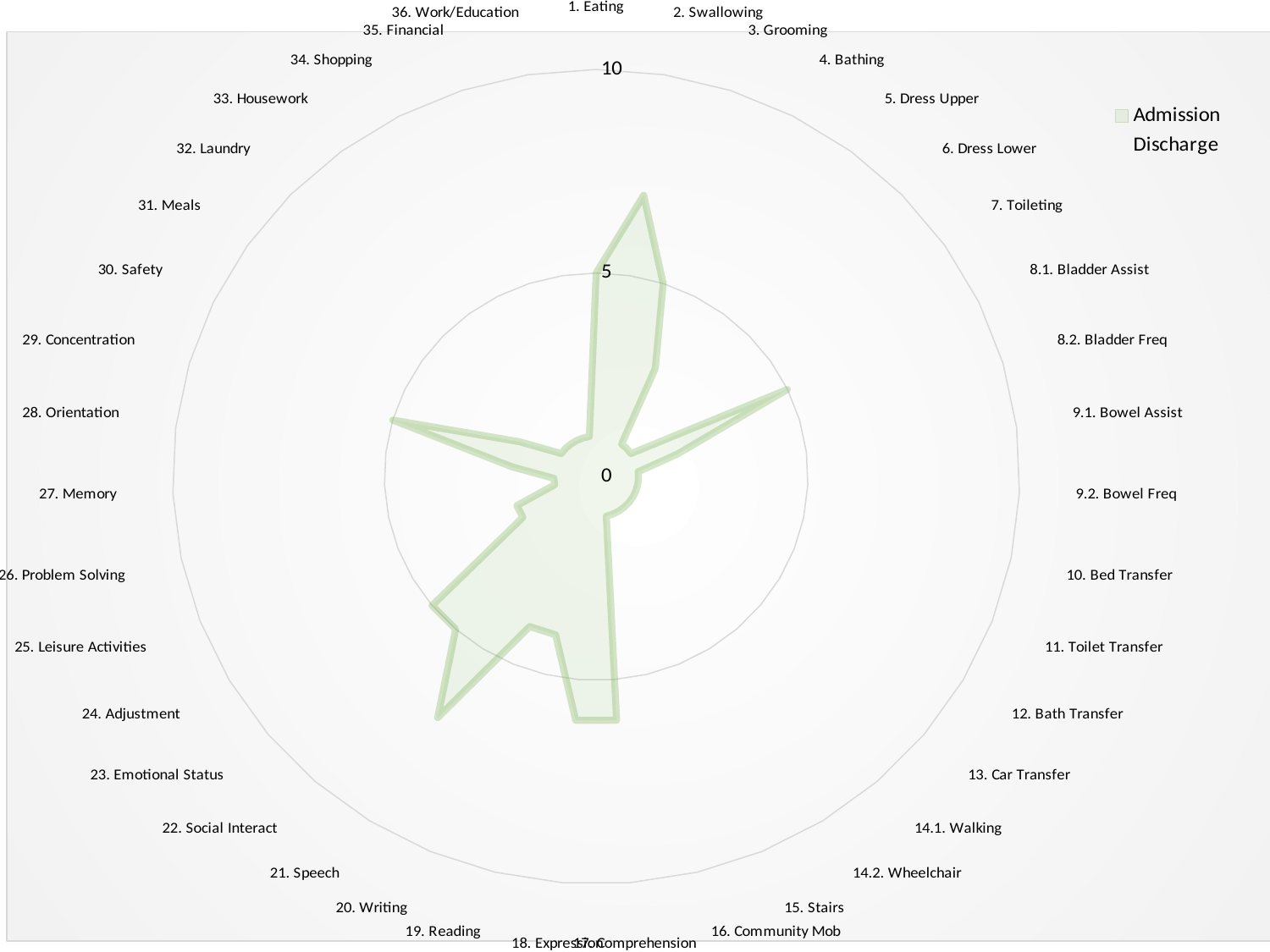
Is the value for 7. Toileting greater or less than 5? less Is the value for 2. Swallowing greater or less than 5? greater How many categories are plotted around the radar chart? 39 Is the value for 20. Writing greater or less than 5? less What kind of chart is shown on the slide? Radar chart What is the maximum value shown on the radial axis? 10 How many series does the legend list? 2 What are the two series named in the legend? Admission and Discharge